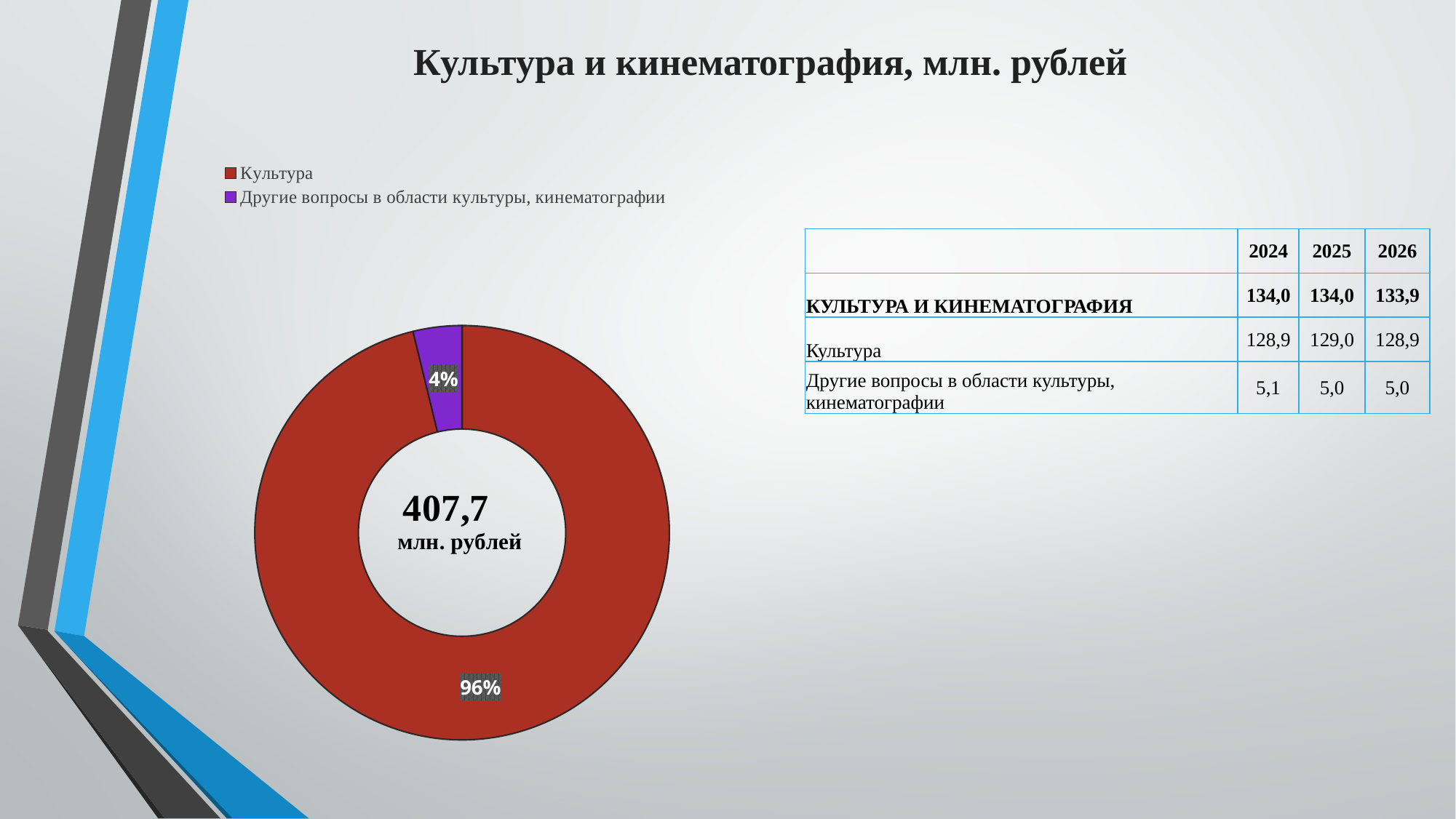
How many slices does the doughnut chart have? 2 What share of the doughnut chart does Культура take? 96% Which category has the largest slice in the doughnut chart? Культура How many categories does the legend of the doughnut chart list? 2 Which category has the smallest slice in the doughnut chart? Другие вопросы в области культуры, кинематографии What is the difference in percentage points between the Культура slice and the Другие вопросы в области культуры, кинематографии slice? 92 percentage points Which slice is larger: Культура or Другие вопросы в области культуры, кинематографии? Культура What total value is printed in the centre of the doughnut chart? 407,7 млн. рублей What share of the doughnut chart does Другие вопросы в области культуры, кинематографии take? 4% What colour is the Культура slice in the doughnut chart? Red What kind of chart is shown on the slide? Doughnut (pie) chart What is the title of the slide containing the doughnut chart? Культура и кинематография, млн. рублей